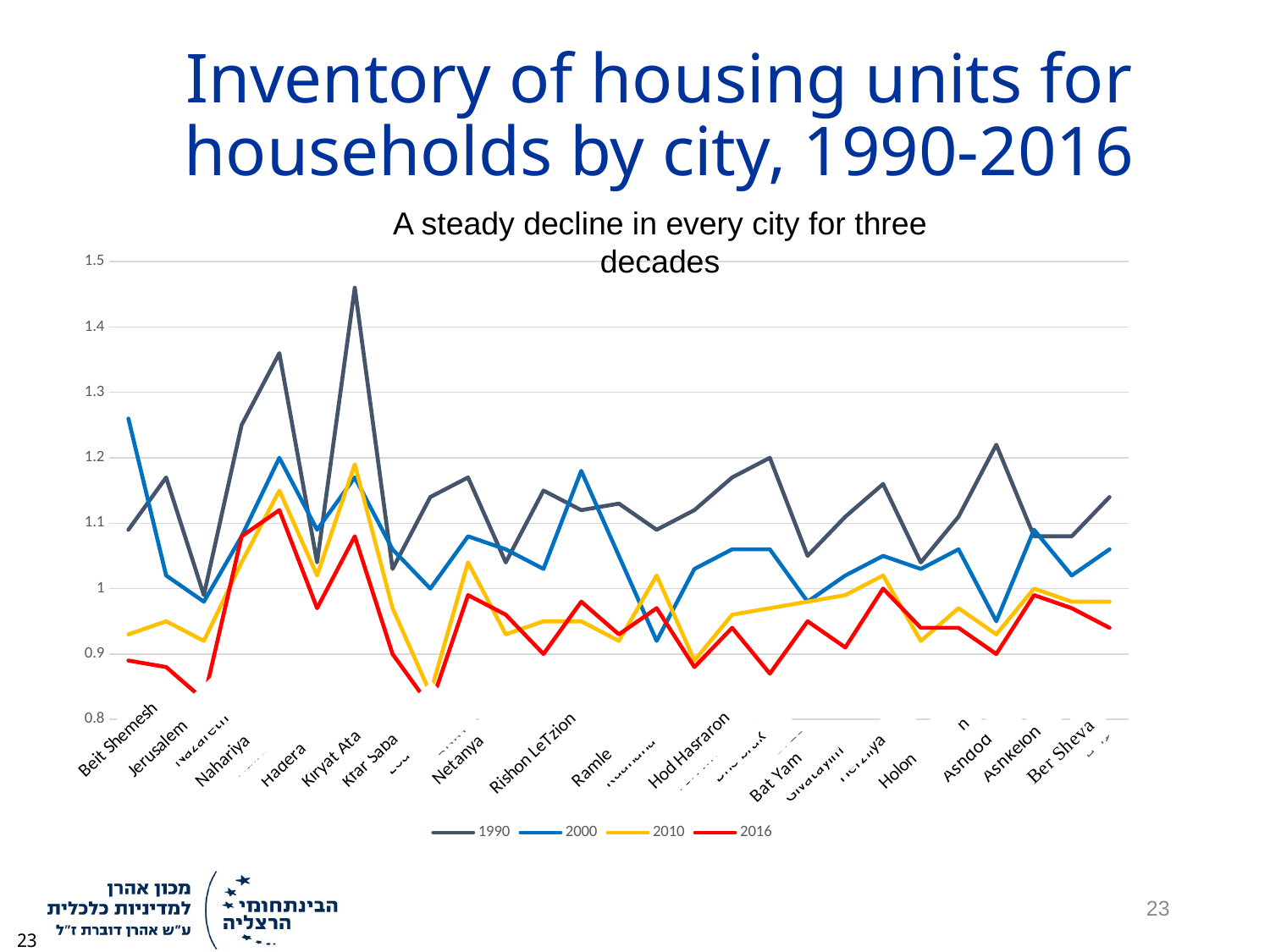
How many series does the legend list? 4 For Kiryat Ata, which is larger: the 1990 value or the 2016 value? 1990 What colour is the line for the 2016 series? Red Which city has the highest value in the 2000 series? Beit Shemesh Which city has the highest value in the 1990 series? Kiryat Ata Is the 2000 value for Beit Shemesh greater or less than 1.2? greater Is the 1990 value for Kiryat Ata greater or less than 1.4? greater What kind of chart is shown on the slide? Line chart Which years are listed in the legend? 1990, 2000, 2010, 2016 Is the 2000 value for Rishon LeTzion greater or less than 1.1? less